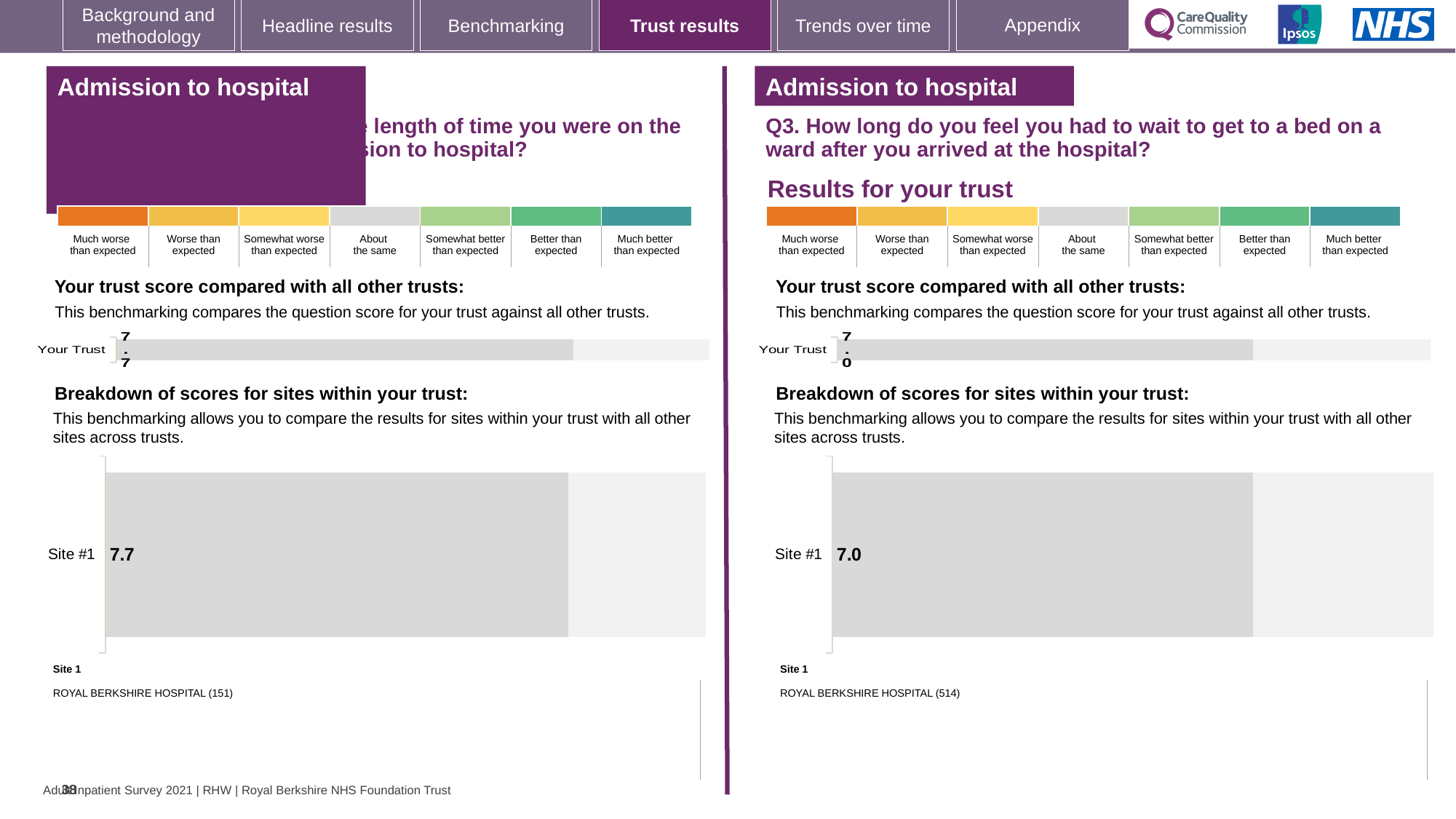
How many sites are shown in the 'Breakdown of scores for sites within your trust' chart on the right panel (Q3)? 1 On the right panel (Q3), what is the 'Your Trust' score in the 'Your trust score compared with all other trusts' chart? 7.0 What kind of chart is used to show the Site #1 score on the left panel? Bar chart Which is larger: the Site #1 score on the left panel or the Site #1 score on the right panel (Q3)? Left panel (7.7) What is the difference between the Site #1 score on the left panel (7.7) and the Site #1 score on the right panel (7.0)? 0.7 On the left panel, what is the score shown for Site #1 in the 'Breakdown of scores for sites within your trust' chart? 7.7 On the right panel (Q3), what is the score shown for Site #1 in the 'Breakdown of scores for sites within your trust' chart? 7.0 On the left panel, which site name is listed under 'Site 1' below the chart? ROYAL BERKSHIRE HOSPITAL (151) On the right panel (Q3), which site name is listed under 'Site 1' below the chart? ROYAL BERKSHIRE HOSPITAL (514) On the right panel (Q3), is the Site #1 score the same as the 'Your Trust' score? Yes, both are 7.0 On the left panel, what is the 'Your Trust' score in the 'Your trust score compared with all other trusts' chart? 7.7